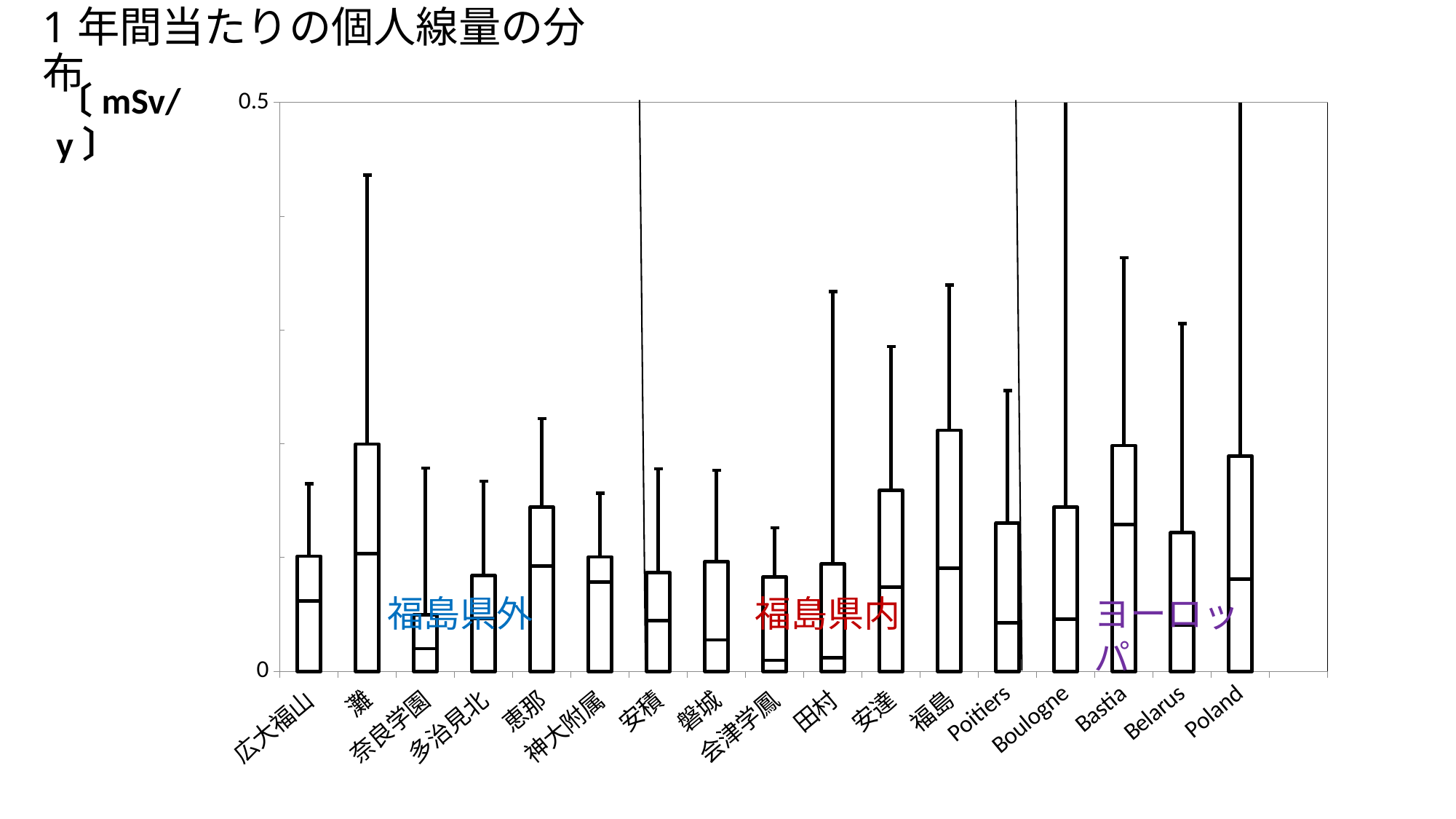
Which category has the lowest top of its box? 奈良学園 How many categories (schools/locations) are plotted along the x axis? 17 What kind of chart is shown on the slide? box plot (box-and-whisker chart) Which has the higher top of its box, 安達 or 磐城? 安達 What unit is shown for the y axis? mSv/y Among the 福島県外 group, which category has the highest upper whisker? 灘 Which category has the lowest upper whisker? 会津学鳳 Is the upper whisker of 灘 greater or less than 0.5? less Which has the higher median, Bastia or Belarus? Bastia Which category has the highest median line? Bastia